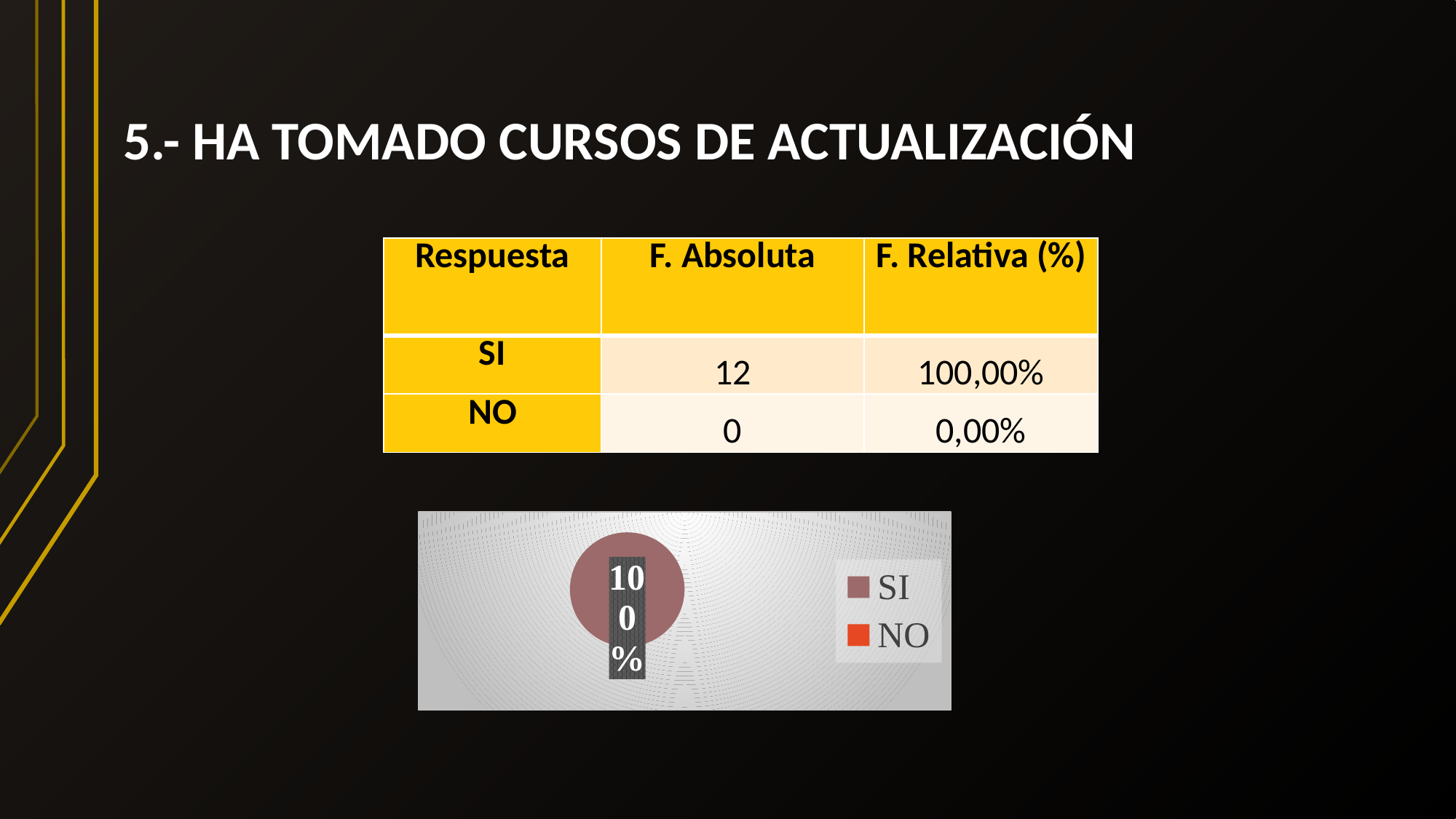
Which category has the smallest share in the pie chart? NO What are the two legend entries of the pie chart? SI and NO What is the only percentage label printed on the pie chart? 100% Which category has the largest slice in the pie chart? SI Which is larger in the pie chart, SI or NO? SI How many series does the legend of the pie chart list? 2 What colour is the SI slice in the pie chart? dark red What kind of chart is shown on the slide? pie chart Is the share for SI in the pie chart greater or less than 50%? greater What share of the pie chart does SI represent? 100%